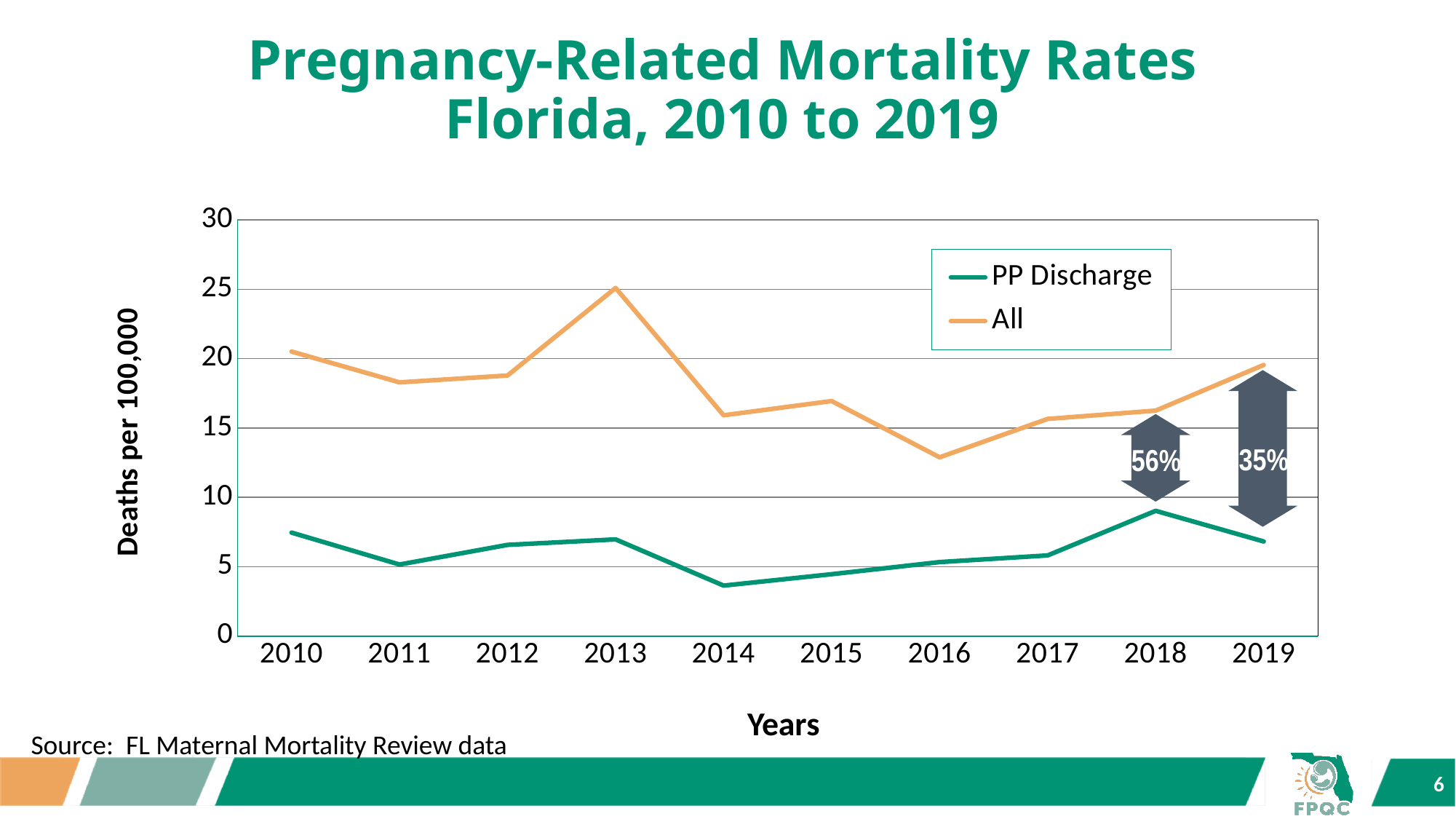
How many years are plotted along the x axis? 10 What is the label on the y axis? Deaths per 100,000 In which year does the PP Discharge series reach its lowest value? 2014 Is the value for the PP Discharge series in 2014 greater or less than 5? less In which year does the PP Discharge series reach its highest value? 2018 What kind of chart is shown on the slide? Line chart How many series does the legend list? 2 In which year does the All series reach its highest value? 2013 Is the value for the All series in 2013 greater or less than 20? greater Which is larger for the All series: the value in 2013 or the value in 2014? 2013 Does the All series rise or fall from 2016 to 2019? Rise In which year does the All series reach its lowest value? 2016